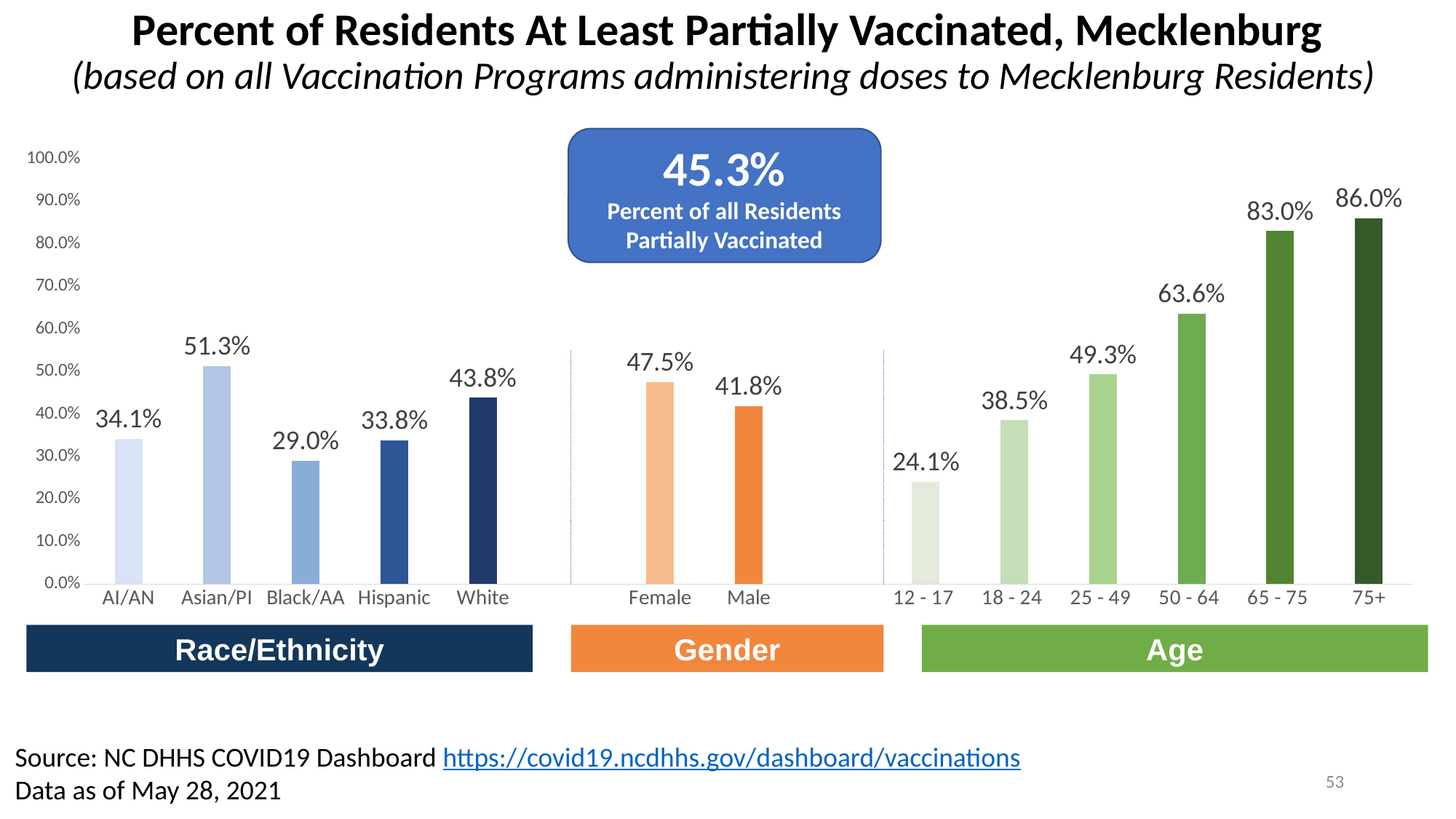
What is the difference between the Female and Male values? 5.7% Is the value for the 65 - 75 age group greater or less than 80.0%? greater What is the value for the 50 - 64 age group? 63.6% How many age groups are shown on the chart? 6 Which age group has the highest percent partially vaccinated? 75+ What percent of Asian/PI residents are at least partially vaccinated? 51.3% What is the value for Female residents? 47.5% What is the difference between the 75+ and 12 - 17 age groups? 61.9% What kind of chart is shown on the slide? bar chart Which race/ethnicity group has the lowest percent partially vaccinated? Black/AA Do the values rise or fall across the age groups from 12 - 17 to 75+? rise Which is larger, the value for White or the value for Hispanic? White